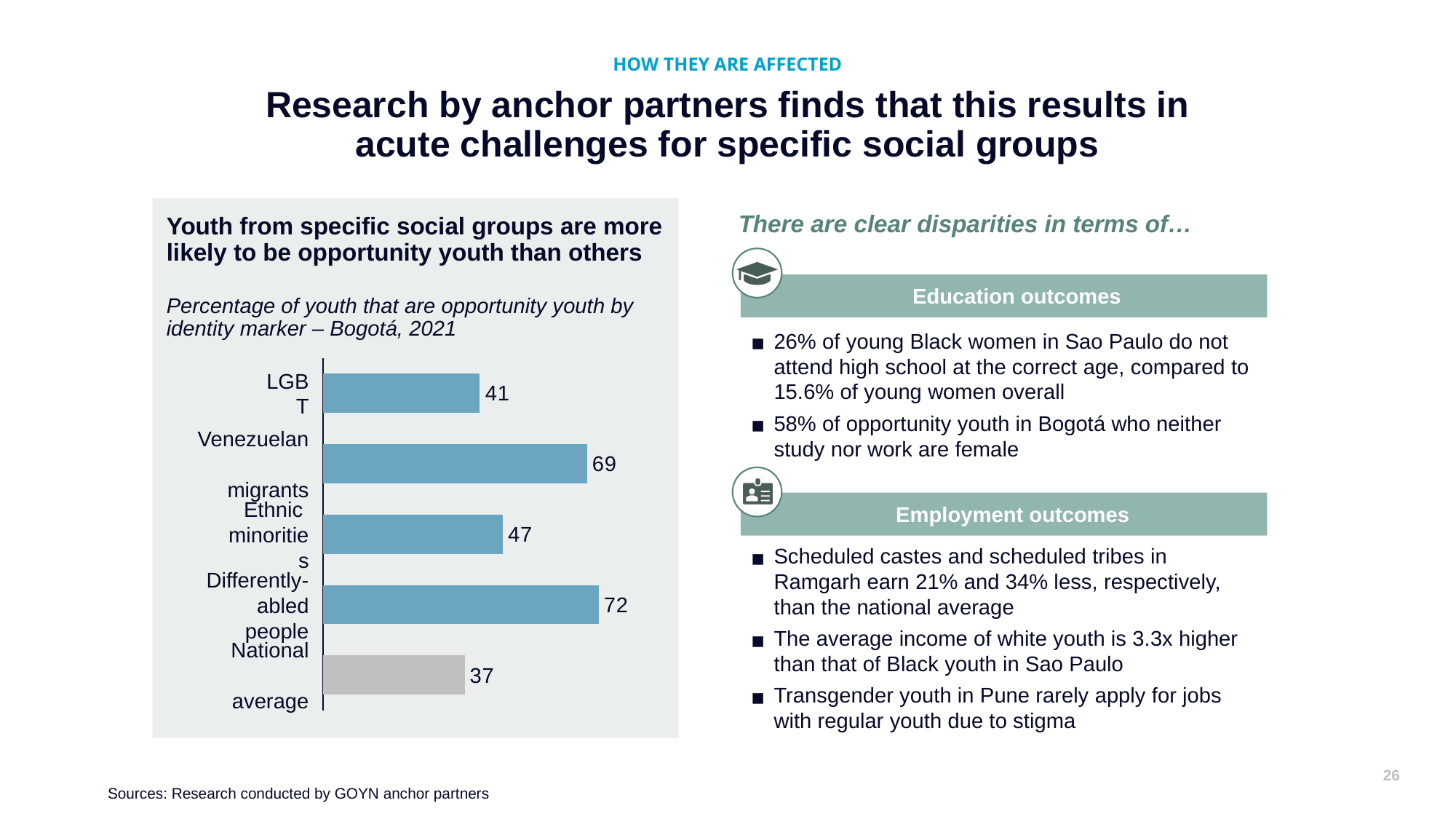
Which category has the lowest value? National average Which is larger, the value for LGBT or the value for Ethnic minorities? Ethnic minorities What kind of chart is shown on the slide? Bar chart Which category has the highest value? Differently-abled people What is the value for LGBT? 41 Which bar is shown in a different colour (grey) from the others? National average What is the value for Venezuelan migrants? 69 What is the value for the National average? 37 How many categories are shown in the chart? 5 What is the difference between the value for Differently-abled people and the National average? 35 What is the value for Ethnic minorities? 47 What is the value for Differently-abled people? 72